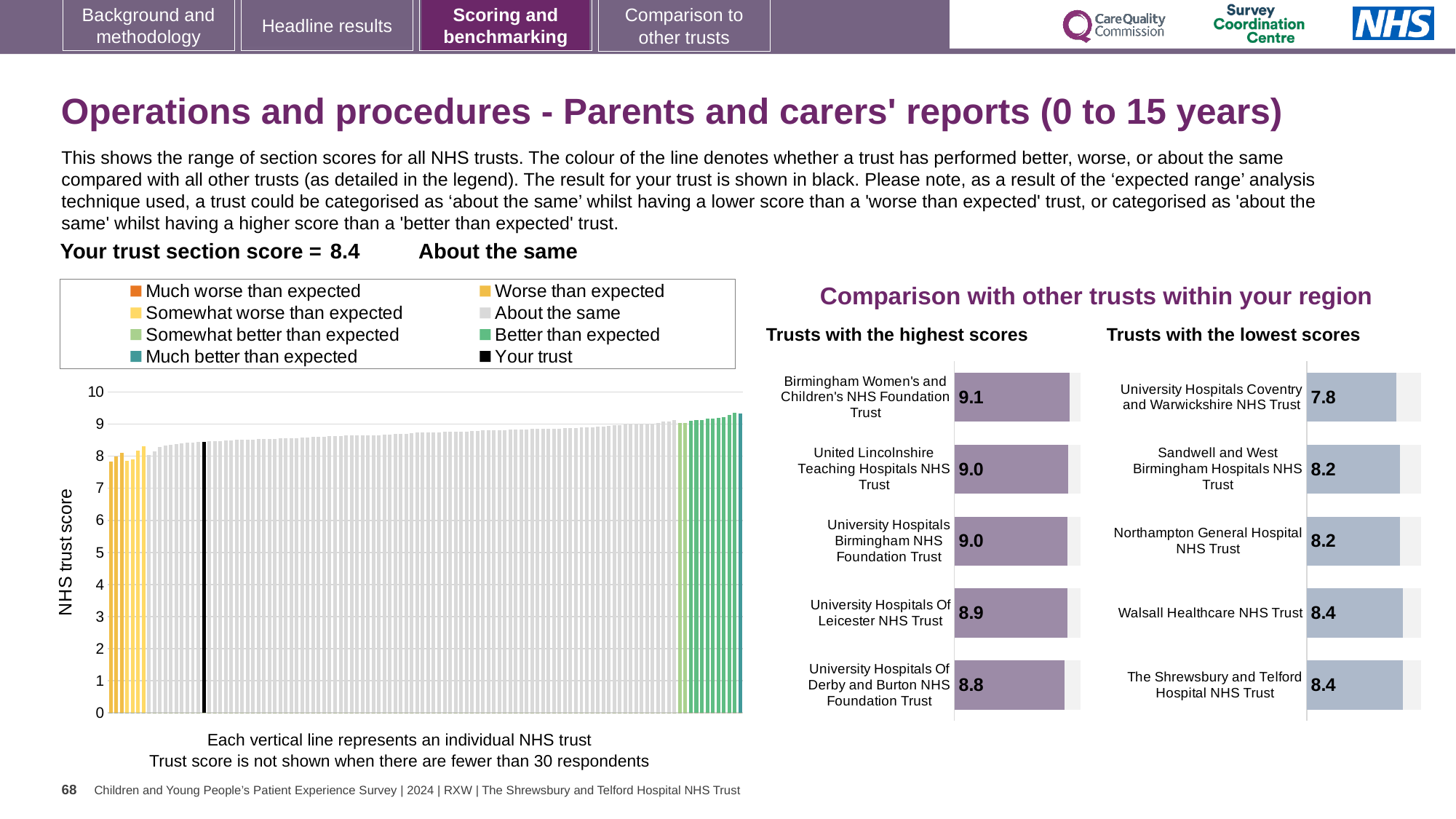
In the 'Trusts with the lowest scores' chart, which trust has the lowest score? University Hospitals Coventry and Warwickshire NHS Trust In the 'Trusts with the lowest scores' chart, what is the score for University Hospitals Coventry and Warwickshire NHS Trust? 7.8 In the 'Trusts with the highest scores' chart, what is the score for University Hospitals Of Leicester NHS Trust? 8.9 In the 'Trusts with the highest scores' chart, what is the difference between the scores of Birmingham Women's and Children's NHS Foundation Trust and University Hospitals Of Derby and Burton NHS Foundation Trust? 0.3 In the 'Trusts with the lowest scores' chart, what is the difference between the scores of Walsall Healthcare NHS Trust and University Hospitals Coventry and Warwickshire NHS Trust? 0.6 In the 'Trusts with the highest scores' chart, what is the score for Birmingham Women's and Children's NHS Foundation Trust? 9.1 How many trusts are shown in the 'Trusts with the highest scores' chart? 5 In the 'Trusts with the lowest scores' chart, which has the higher score: Walsall Healthcare NHS Trust or University Hospitals Coventry and Warwickshire NHS Trust? Walsall Healthcare NHS Trust In the NHS trust score chart on the left, do the bar heights rise or fall from left to right? rise In the 'Trusts with the highest scores' chart, which trust has the lowest score? University Hospitals Of Derby and Burton NHS Foundation Trust In the 'Trusts with the lowest scores' chart, what is the score for Northampton General Hospital NHS Trust? 8.2 How many entries does the legend of the NHS trust score chart on the left list? 8